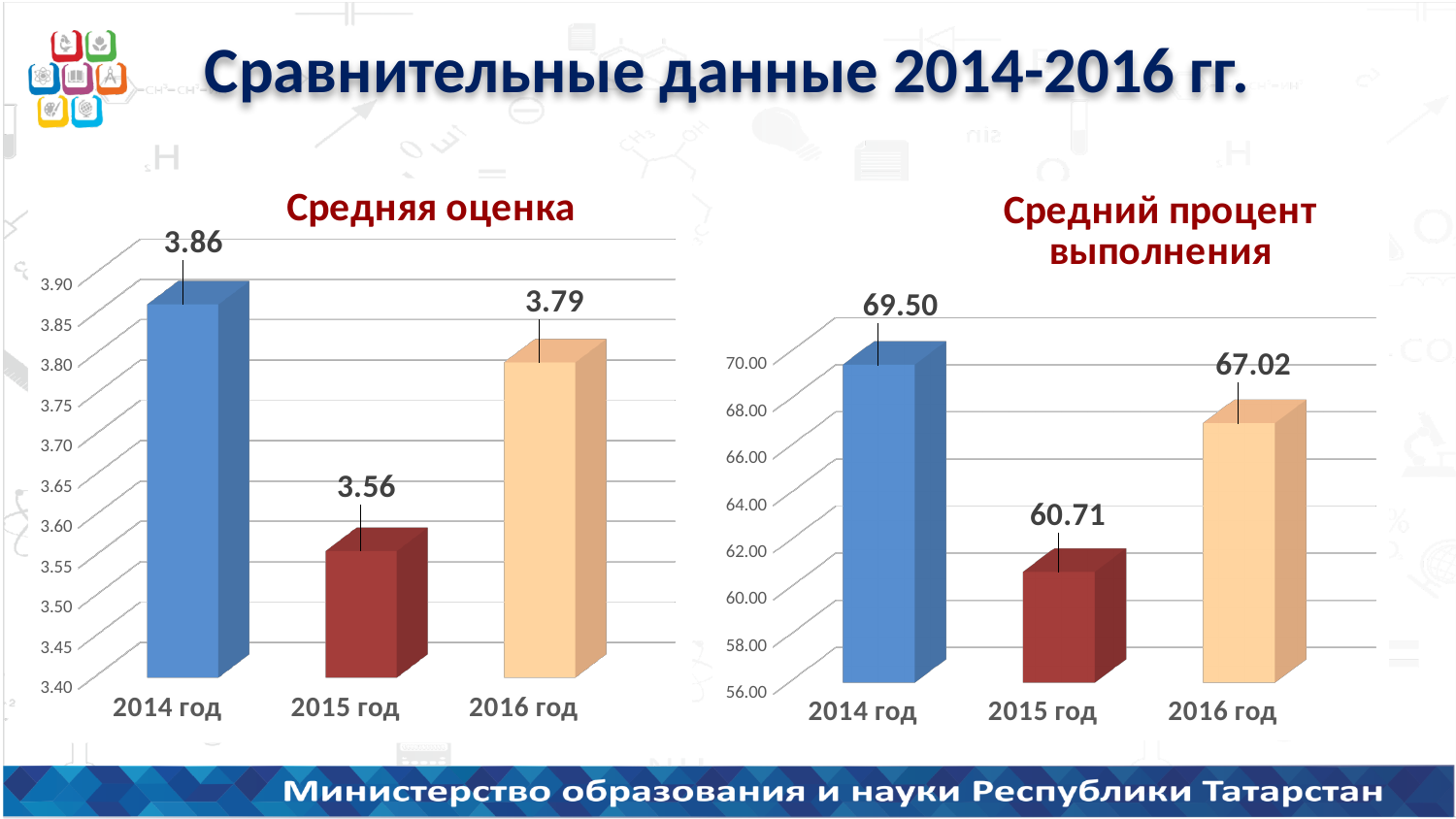
In the 'Средний процент выполнения' chart, which year has the lowest value? 2015 год In the 'Средняя оценка' chart, what is the value for 2014 год? 3.86 What type of chart is the 'Средний процент выполнения' chart? Bar chart In the 'Средняя оценка' chart, which year has the highest value? 2014 год In the 'Средний процент выполнения' chart, what is the value for 2015 год? 60.71 In the 'Средний процент выполнения' chart, which is larger: the value for 2016 год or the value for 2015 год? 2016 год In the 'Средняя оценка' chart, what is the value for 2015 год? 3.56 What is the title of the chart on the left side of the slide? Средняя оценка In the 'Средний процент выполнения' chart, what is the difference between the values for 2014 год and 2015 год? 8.79 In the 'Средняя оценка' chart, what is the difference between the values for 2014 год and 2016 год? 0.07 How many categories are shown in the 'Средняя оценка' chart? 3 In the 'Средний процент выполнения' chart, what is the value for 2016 год? 67.02